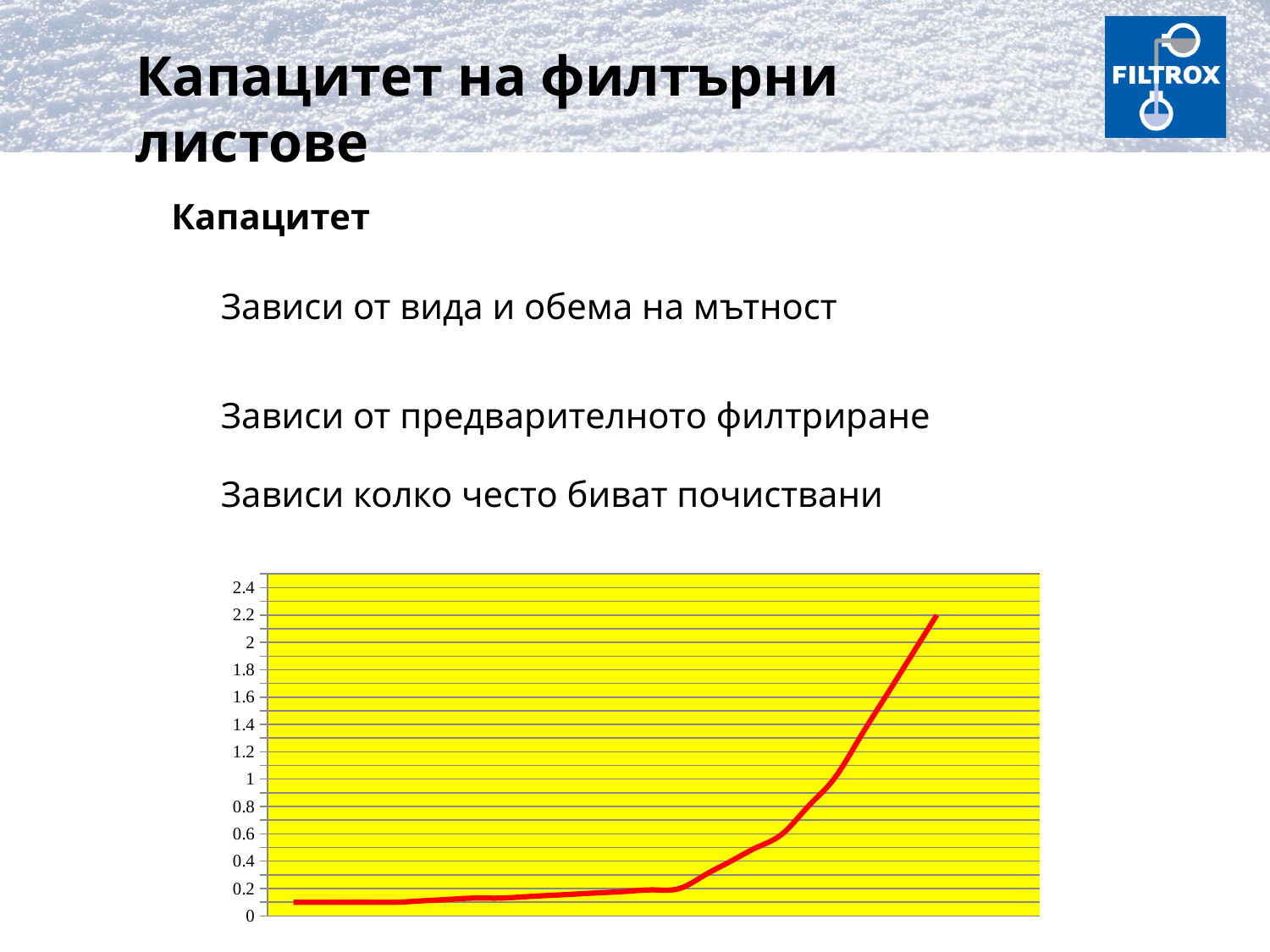
Is the value at the right end of the line greater or less than 2? greater At which end of the chart, left or right, does the line have its lowest value? left What is the highest value labelled on the y axis? 2.4 Do the values of the line rise or fall from left to right along the x axis? rise At which end of the chart, left or right, does the line reach its highest value? right What colour is the plotted line? red Is the value at the left end of the line greater or less than 0.4? less Is the value of the line at the horizontal midpoint of the chart greater or less than 0.6? less What kind of chart is shown on the slide? line chart What colour is the plot area background of the chart? yellow What is the lowest value labelled on the y axis? 0